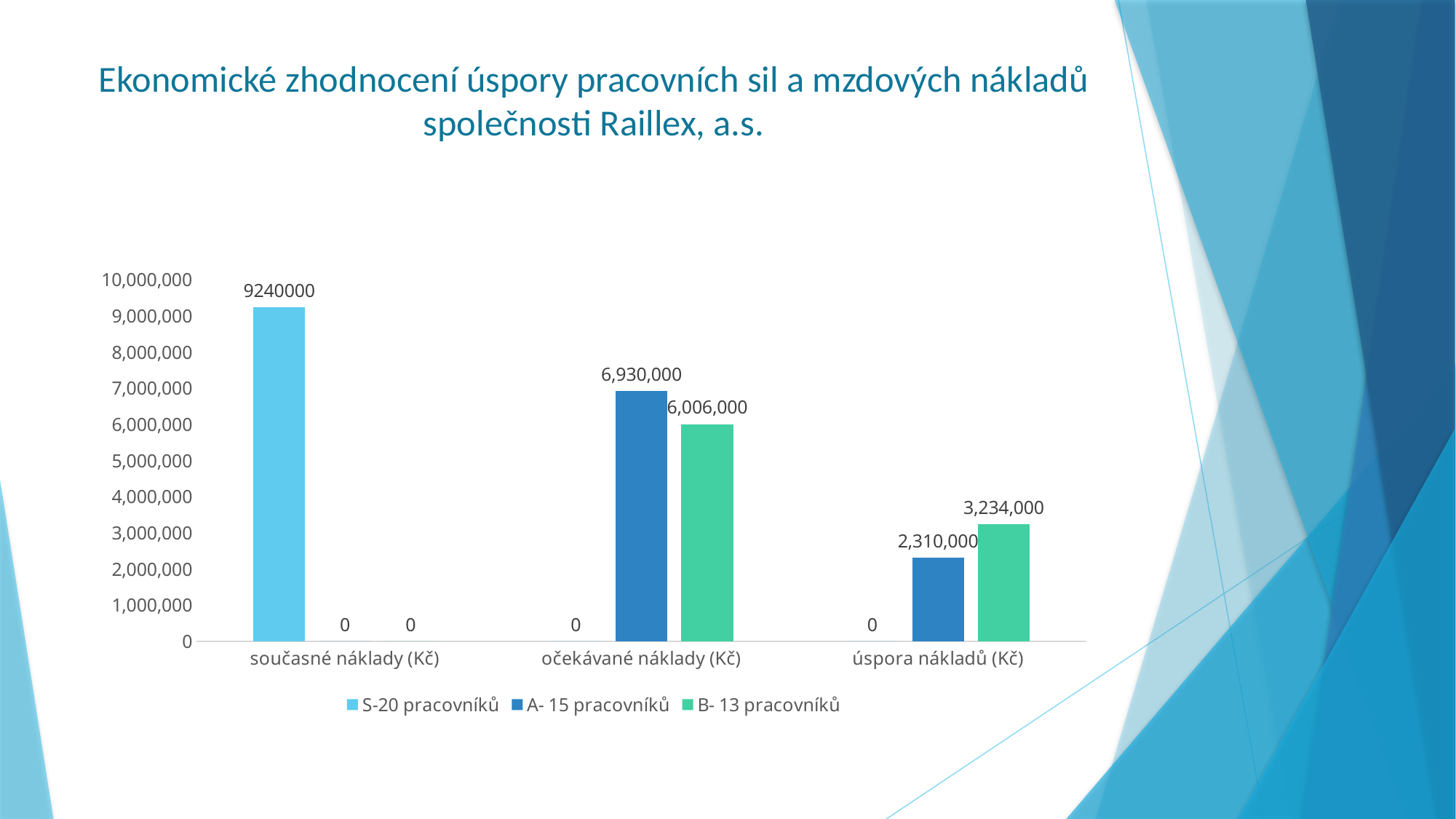
How many series does the legend list? 3 What is the difference between the A- 15 pracovníků and B- 13 pracovníků values in the očekávané náklady (Kč) category? 924,000 Which series is shown in light blue in the legend? S-20 pracovníků What is the value for S-20 pracovníků in the současné náklady (Kč) category? 9240000 What is the difference between the B- 13 pracovníků and A- 15 pracovníků values in the úspora nákladů (Kč) category? 924,000 What is the value for B- 13 pracovníků in the úspora nákladů (Kč) category? 3,234,000 What is the value for B- 13 pracovníků in the očekávané náklady (Kč) category? 6,006,000 How many categories are shown on the x axis? 3 Which series has the higher value in the úspora nákladů (Kč) category, A- 15 pracovníků or B- 13 pracovníků? B- 13 pracovníků What type of chart is shown on the slide? bar chart What is the value for A- 15 pracovníků in the úspora nákladů (Kč) category? 2,310,000 What is the value for A- 15 pracovníků in the očekávané náklady (Kč) category? 6,930,000